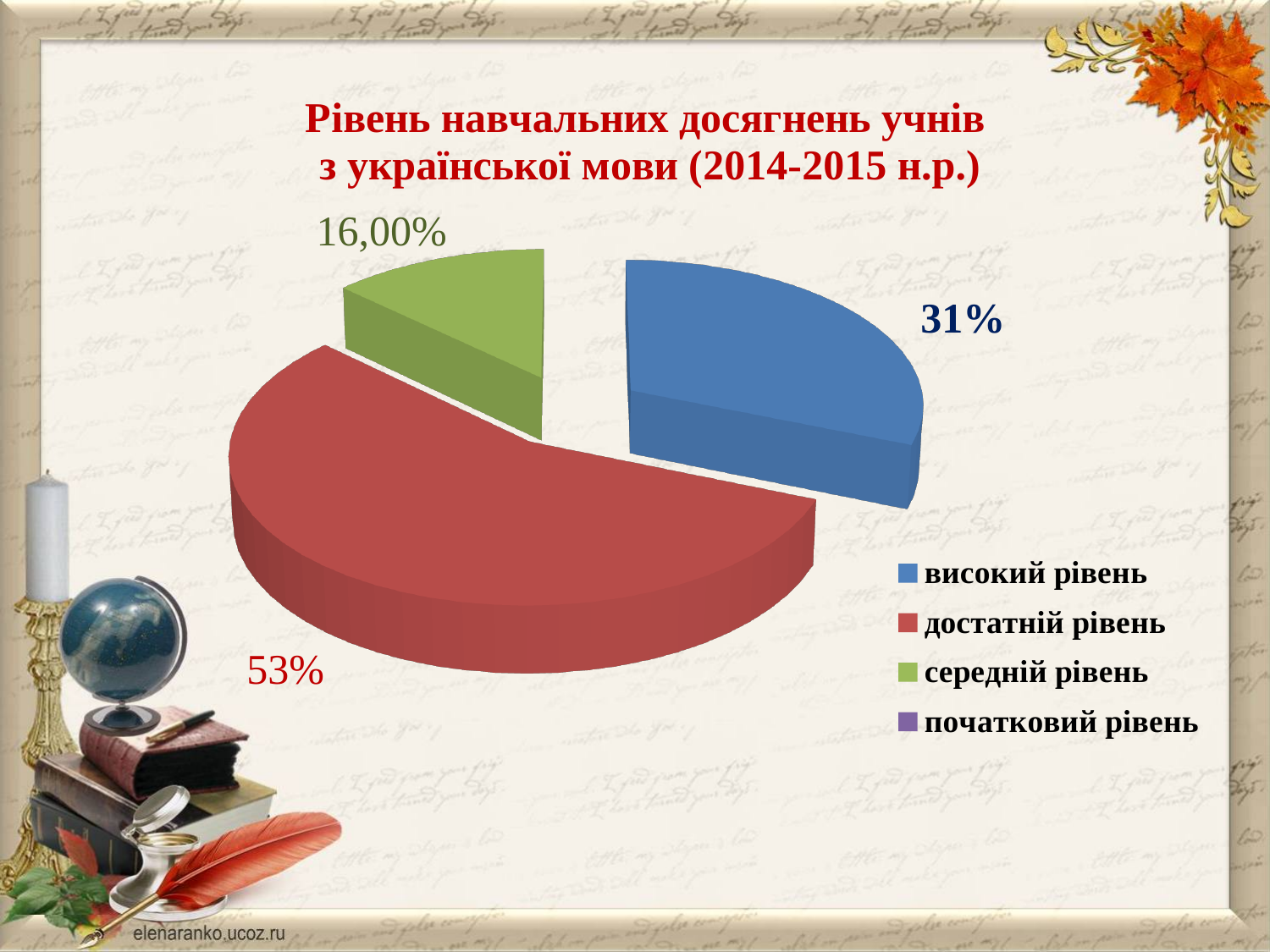
Which level has the largest slice of the pie? достатній рівень How many slices are visible in the pie? 3 What value is shown for the високий рівень slice? 31% What colour is the slice for достатній рівень? red Of the three slices with printed values, which is the smallest? середній рівень By how many percentage points does достатній рівень exceed високий рівень? 22% What is the title of the chart? Рівень навчальних досягнень учнів з української мови (2014-2015 н.р.) Which is larger, the slice for високий рівень or the slice for середній рівень? високий рівень What percentage of the pie is labelled for достатній рівень? 53% What value is printed next to the середній рівень slice? 16,00% What kind of chart is shown on the slide? pie chart How many entries does the legend list? 4